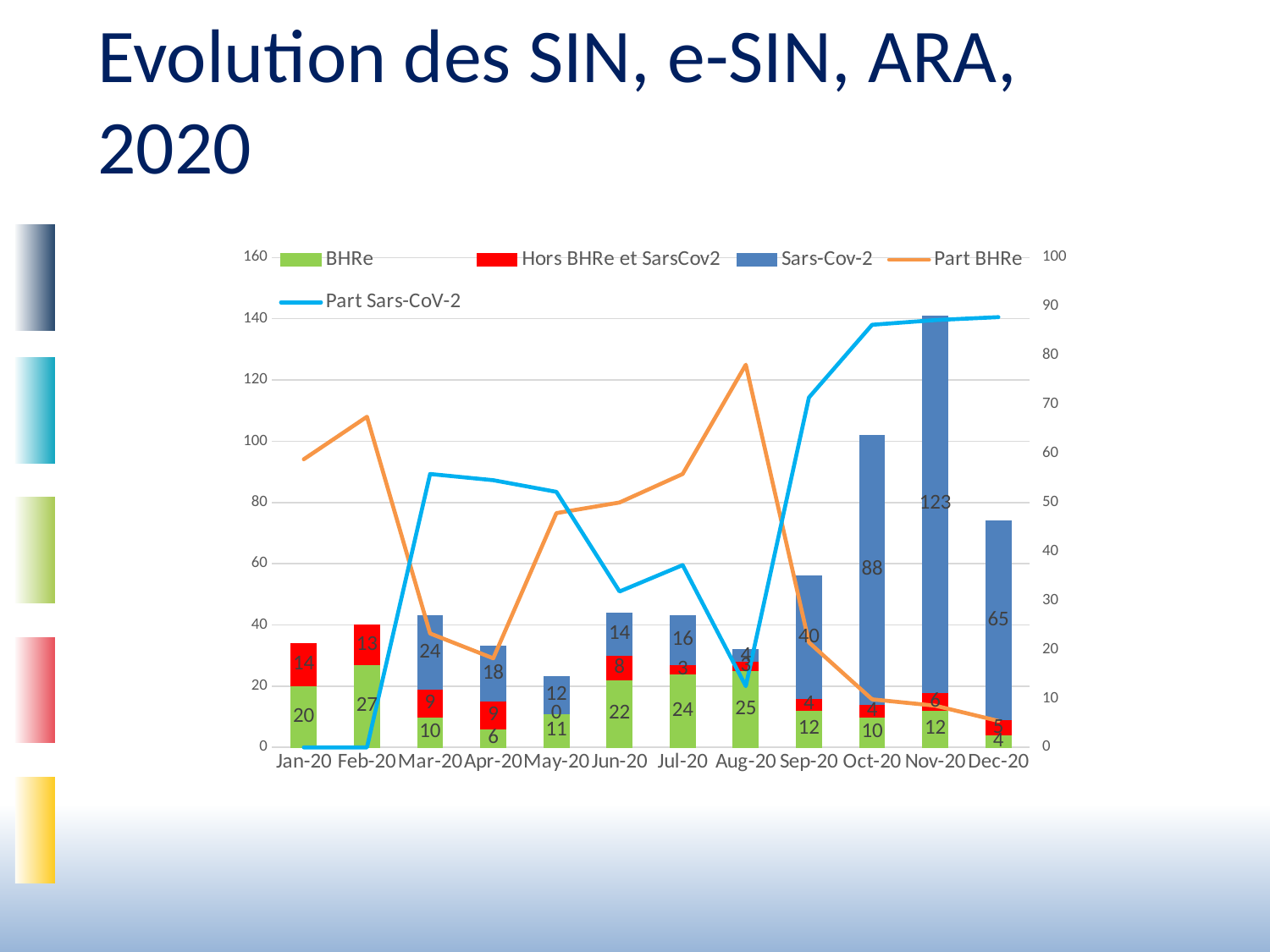
How many months are shown on the x axis? 12 What is the difference between the Sars-Cov-2 values for Nov-20 and Oct-20? 35 Does the Sars-Cov-2 value rise or fall from Aug-20 to Nov-20? rise Is the Part Sars-CoV-2 value for Oct-20 greater or less than 80 on the right axis? greater In which month is the Sars-Cov-2 value highest? Nov-20 What is the BHRe value for Feb-20? 27 How many series does the legend list? 5 What is the total of the stacked bar for Oct-20? 102 Which month has the larger BHRe value, Jun-20 or Jul-20? Jul-20 What is the Sars-Cov-2 value for Nov-20? 123 In which month is the BHRe value lowest? Dec-20 What is the value of Hors BHRe et SarsCov2 for Jan-20? 14